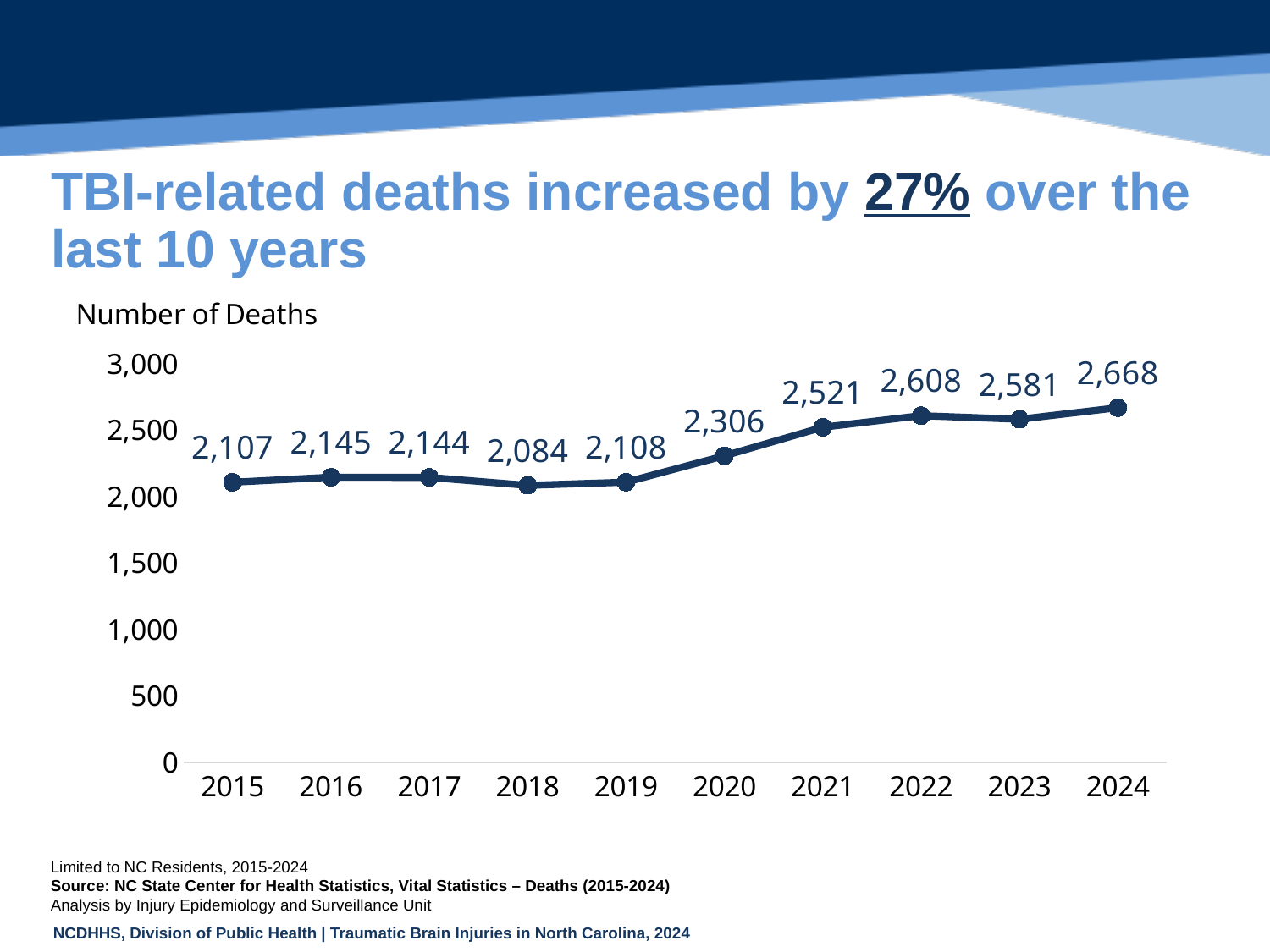
What is the number of deaths in 2015? 2,107 Which year has the lowest number of deaths? 2018 What kind of chart is shown on the slide? Line chart Is the number of deaths in 2021 greater or less than 2,500? greater What is the number of deaths in 2020? 2,306 What is the number of deaths in 2024? 2,668 How many years are plotted on the chart? 10 Which year had more deaths, 2022 or 2023? 2022 Which year has the highest number of deaths? 2024 What is the label of the vertical axis of the chart? Number of Deaths What is the difference in the number of deaths between 2024 and 2015? 561 Do the number of deaths generally rise or fall from 2015 to 2024? Rise